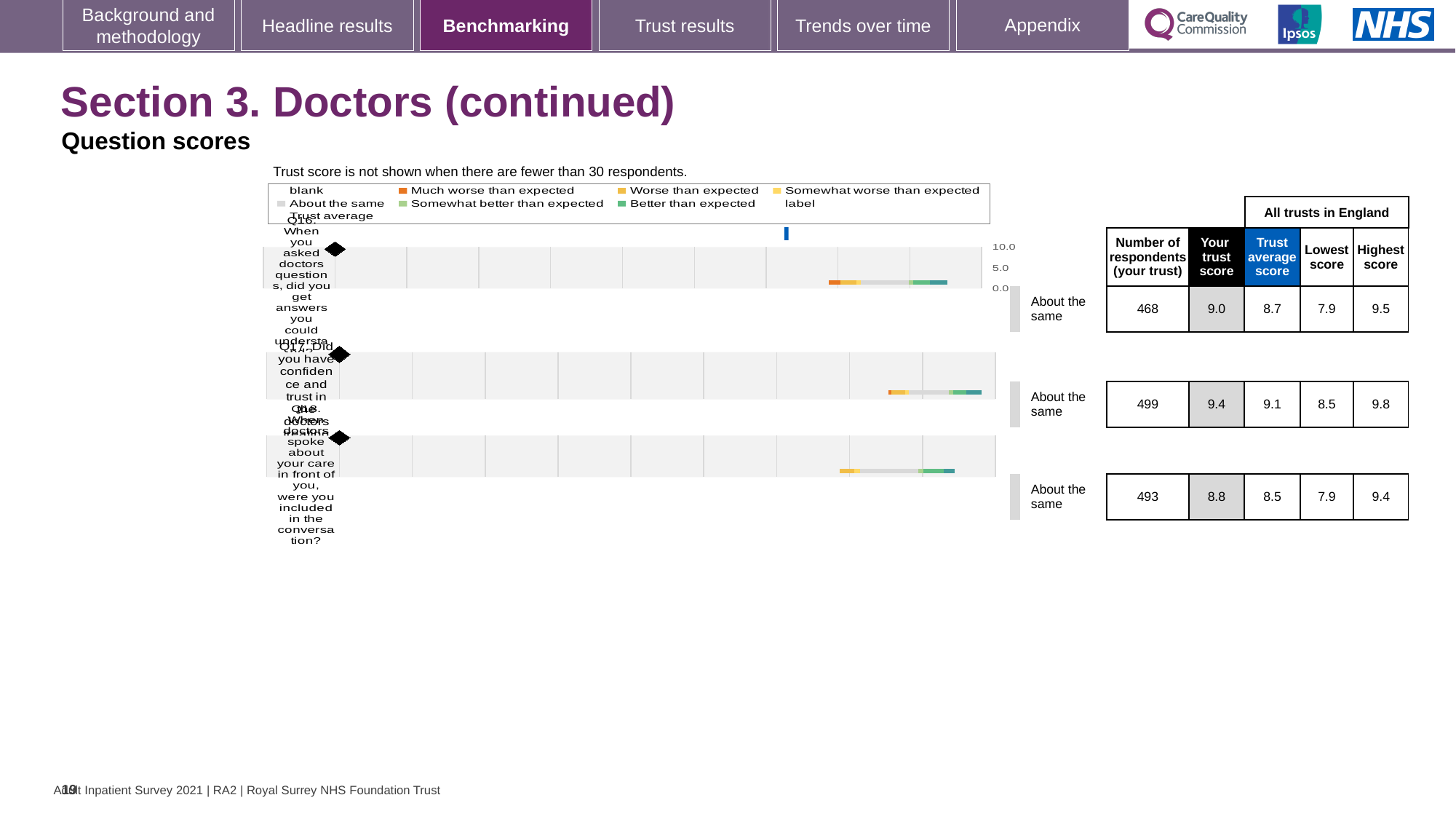
How many respondents from your trust answered Q17 (Did you have confidence and trust in the doctors treating you)? 499 Is your trust score for Q17 higher or lower than the trust average score for Q17? higher What is the trust average score for Q18 (When doctors spoke about your care in front of you, were you included in the conversation)? 8.5 What is the lowest score across all trusts in England for Q16? 7.9 How many questions are plotted on the chart? 3 What benchmark category is shown for Q18? About the same What is the highest score across all trusts in England for Q17? 9.8 What is the difference between your trust score and the trust average score for Q18? 0.3 Which question has the highest 'Your trust score'? Q17 Is your trust score for Q16 greater or less than 5.0 on the chart axis? greater Which question has the fewest respondents from your trust? Q16 What is your trust score for Q16 (When you asked doctors questions, did you get answers you could understand)? 9.0